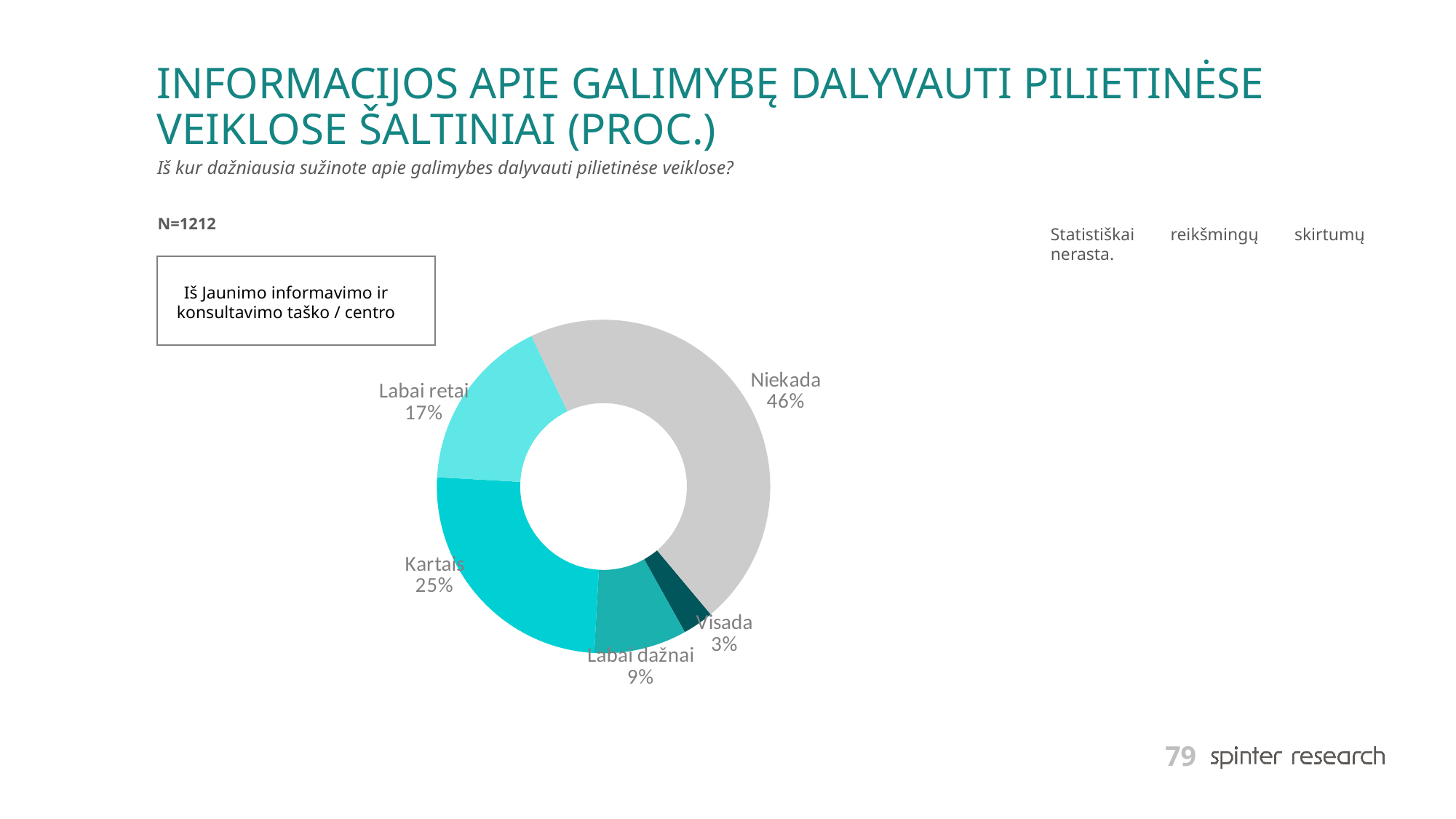
What is the combined share of "Visada" and "Labai dažnai"? 12% What percentage of respondents answered "Niekada"? 46% How many categories are shown in the chart? 5 Which is larger, the value for "Labai retai" or the value for "Labai dažnai"? Labai retai What is the sample size (N) stated on the slide? N=1212 What is the value for "Labai retai"? 17% Which category has the largest share of the pie? Niekada What kind of chart is shown on the slide? Pie chart (doughnut) Which category has the smallest share of the pie? Visada What is the value for "Labai dažnai"? 9% What is the value for "Kartais"? 25% What is the difference between the values for "Niekada" and "Kartais"? 21%